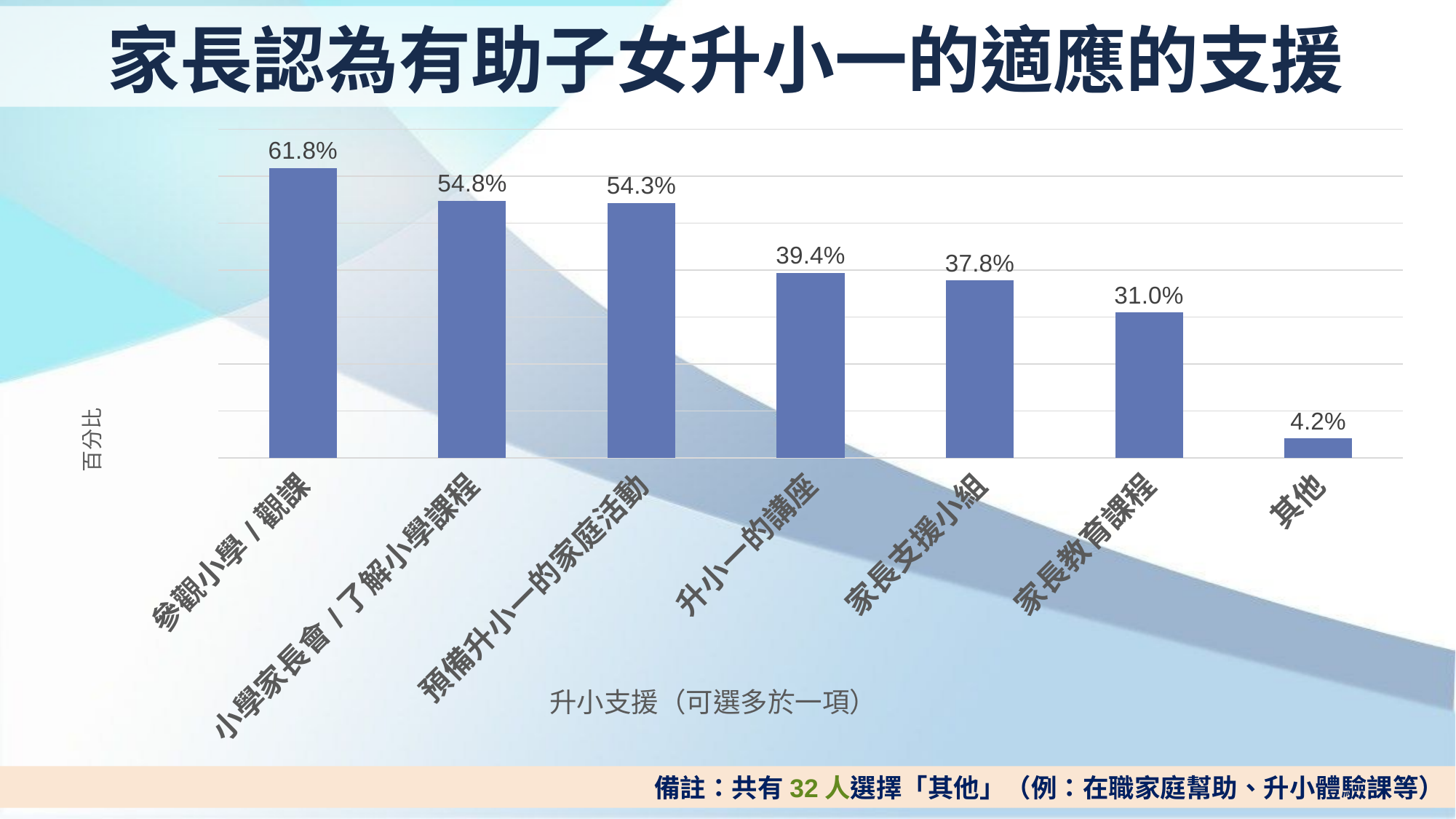
What is the value for 其他? 4.2% What is the difference between the values for 參觀小學 / 觀課 and 家長教育課程? 30.8% What is the value for 參觀小學 / 觀課? 61.8% What is the value for 家長教育課程? 31.0% How many categories are shown in the chart? 7 Which category has the highest value? 參觀小學 / 觀課 Do the values rise or fall from left to right along the x axis? Fall What is the title of the chart? 家長認為有助子女升小一的適應的支援 What is the value for 升小一的講座? 39.4% What kind of chart is shown on the slide? Bar chart Which is larger, the value for 升小一的講座 or the value for 家長支援小組? 升小一的講座 Which category has the lowest value? 其他